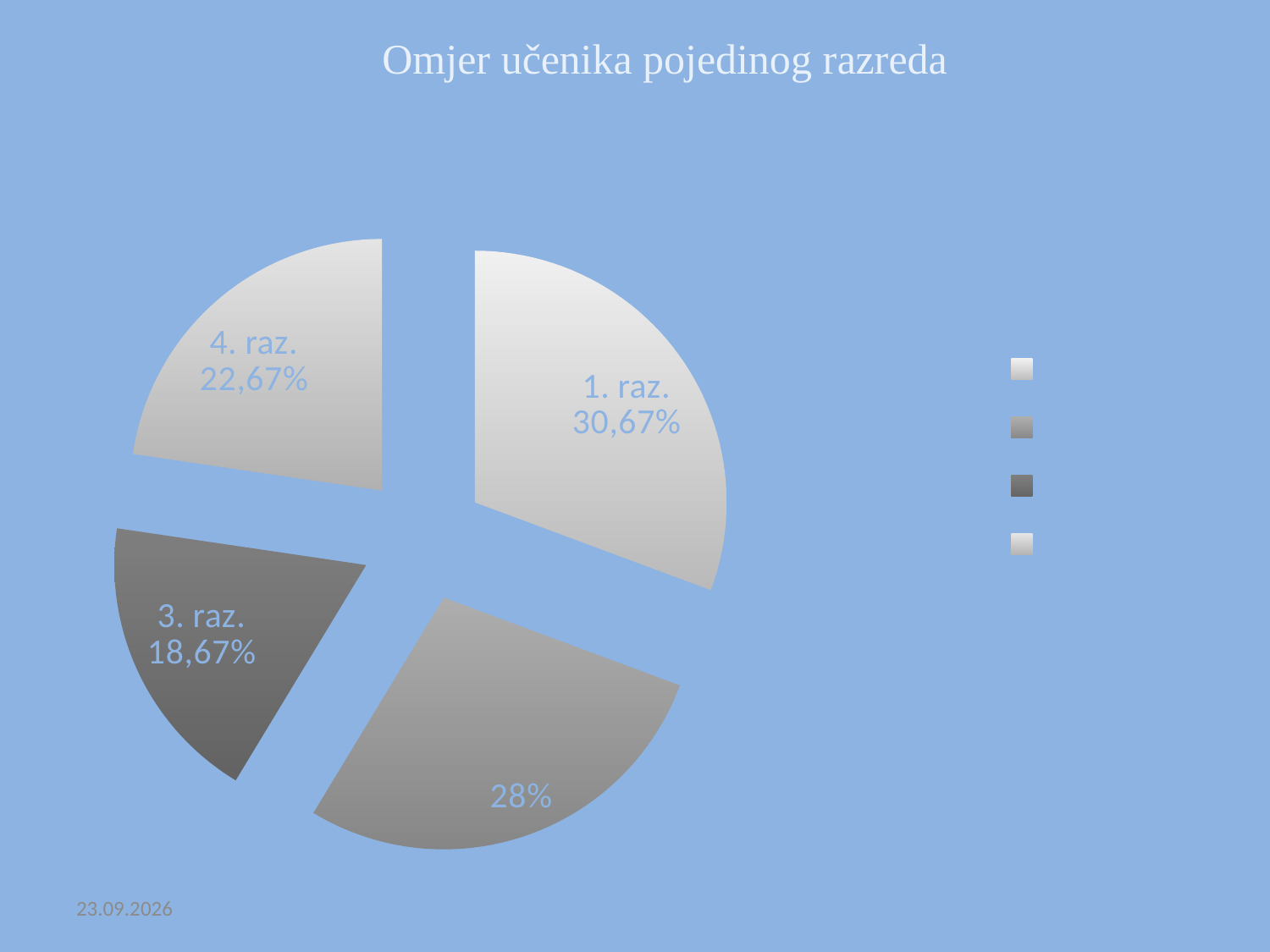
What is the title of the chart? Omjer učenika pojedinog razreda What percentage is shown for 3. raz.? 18,67% How many slices does the pie chart have? 4 What percentage is shown for 1. raz.? 30,67% What kind of chart is shown on the slide? pie chart Which is larger, the share for 4. raz. or the share for 3. raz.? 4. raz. What is the difference between the shares of 1. raz. and 4. raz.? 8% What percentage is shown for 4. raz.? 22,67% What is the difference between the shares of 4. raz. and 3. raz.? 4% Which labelled class has the largest share of the pie? 1. raz. What percentage is shown on the bottom slice of the pie? 28% Which labelled class has the smallest share of the pie? 3. raz.